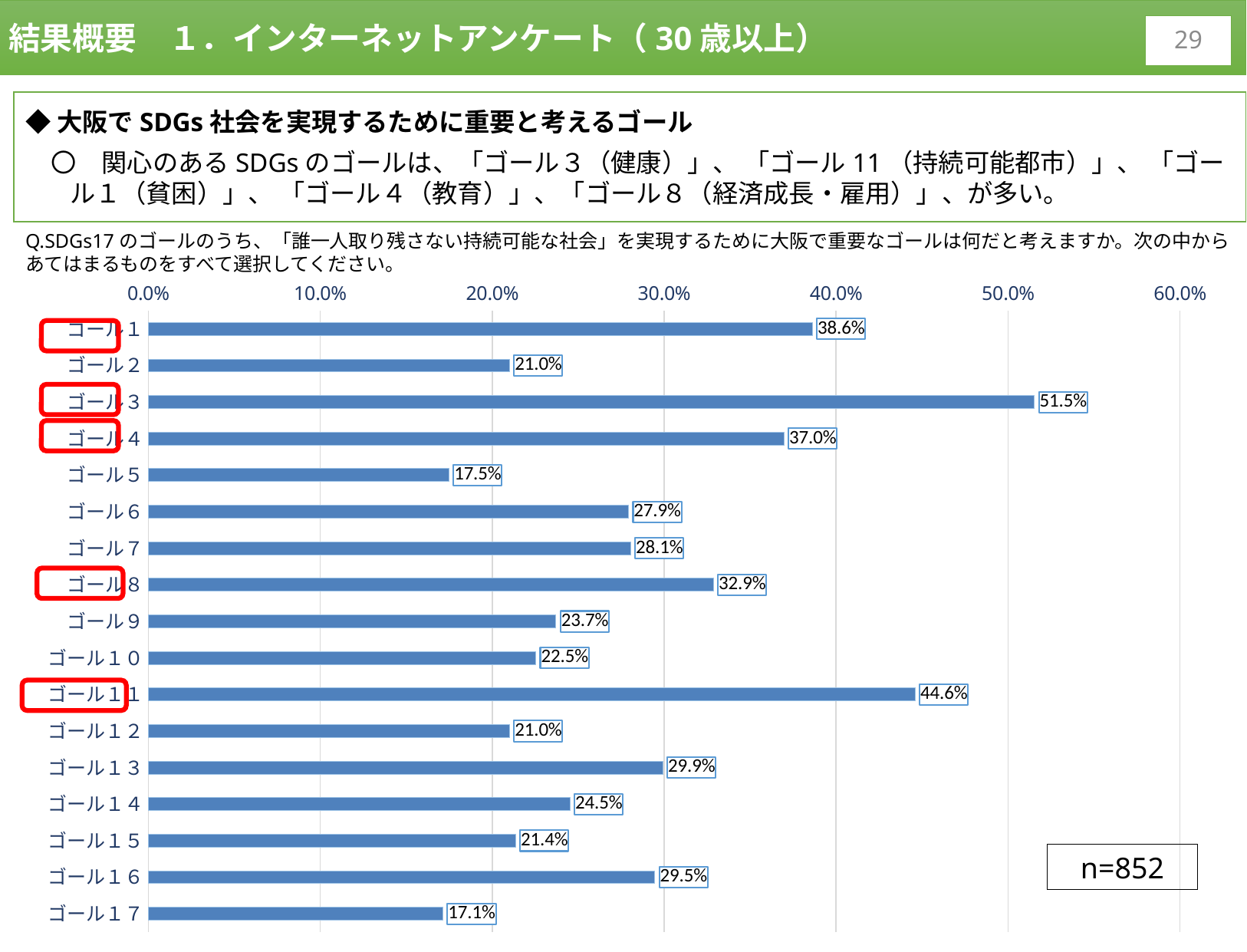
What is the value for ゴール１１? 44.6% Which goal has the highest value? ゴール３ Which is larger, the value for ゴール１ or the value for ゴール４? ゴール１ What is the value for ゴール８? 32.9% Which goal has the lowest value? ゴール１７ How many goals (categories) are shown in the chart? 17 What kind of chart is shown on the slide? bar chart Is the value for ゴール１３ greater or less than 20.0%? greater What is the difference between the values for ゴール３ and ゴール１１? 6.9% What is the sample size (n) shown on the chart? n=852 What is the value for ゴール３? 51.5% What is the value for ゴール１７? 17.1%